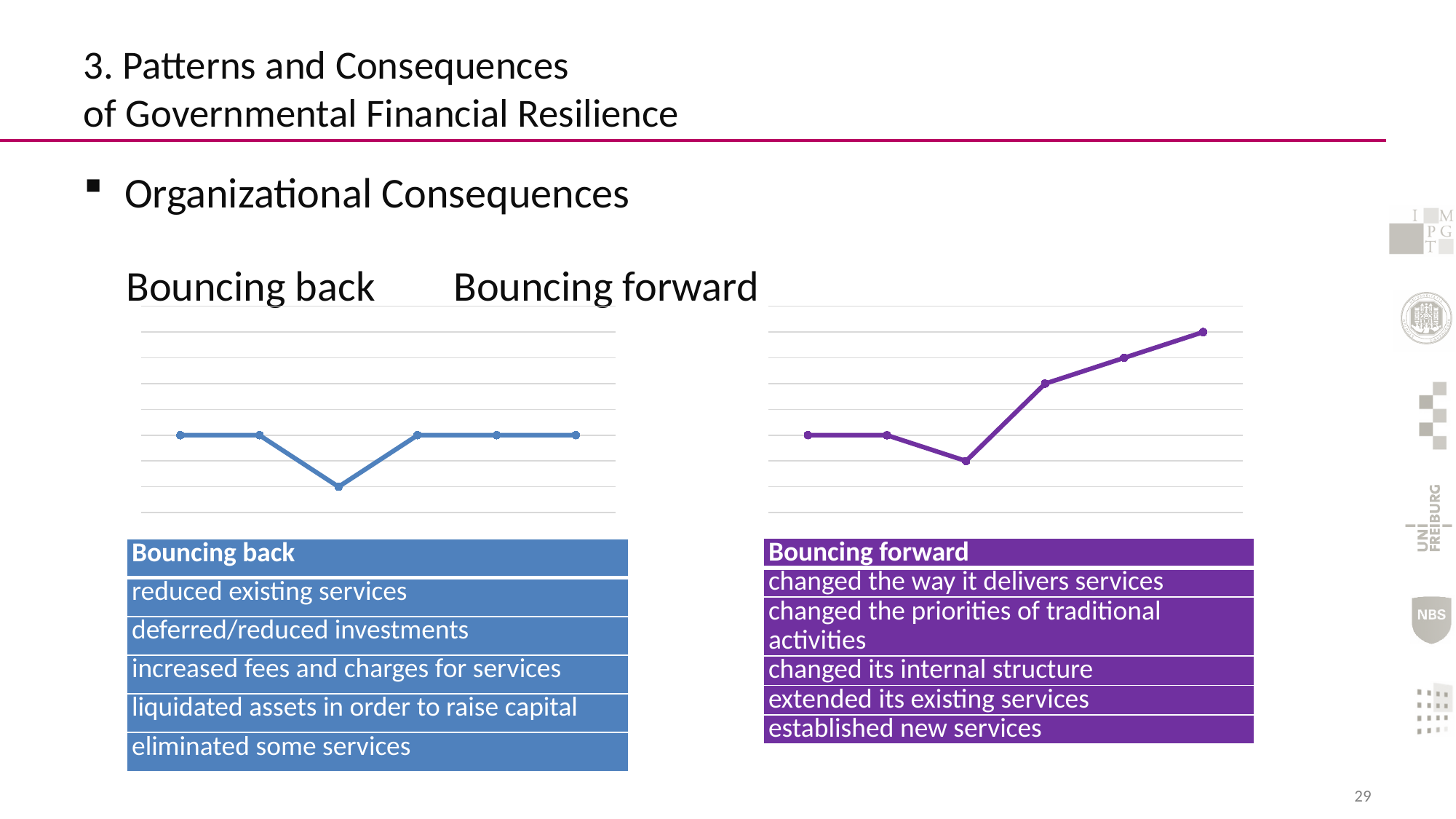
What kind of chart is the 'Bouncing forward' chart on the right? line chart What colour is the line in the 'Bouncing back' chart? blue In the 'Bouncing back' chart, does the line return to its starting level after the dip? yes In the 'Bouncing back' chart, which point is the lowest: the first, third or last? the third In the 'Bouncing forward' chart, do the values rise or fall over the last three points? rise How many data points are plotted on the 'Bouncing forward' chart? 6 How many data points are plotted on the 'Bouncing back' chart? 6 What kind of chart is the 'Bouncing back' chart on the left? line chart What colour is the line in the 'Bouncing forward' chart? purple In the 'Bouncing forward' chart, which point is the highest? the last point In the 'Bouncing forward' chart, is the last point higher or lower than the first point? higher